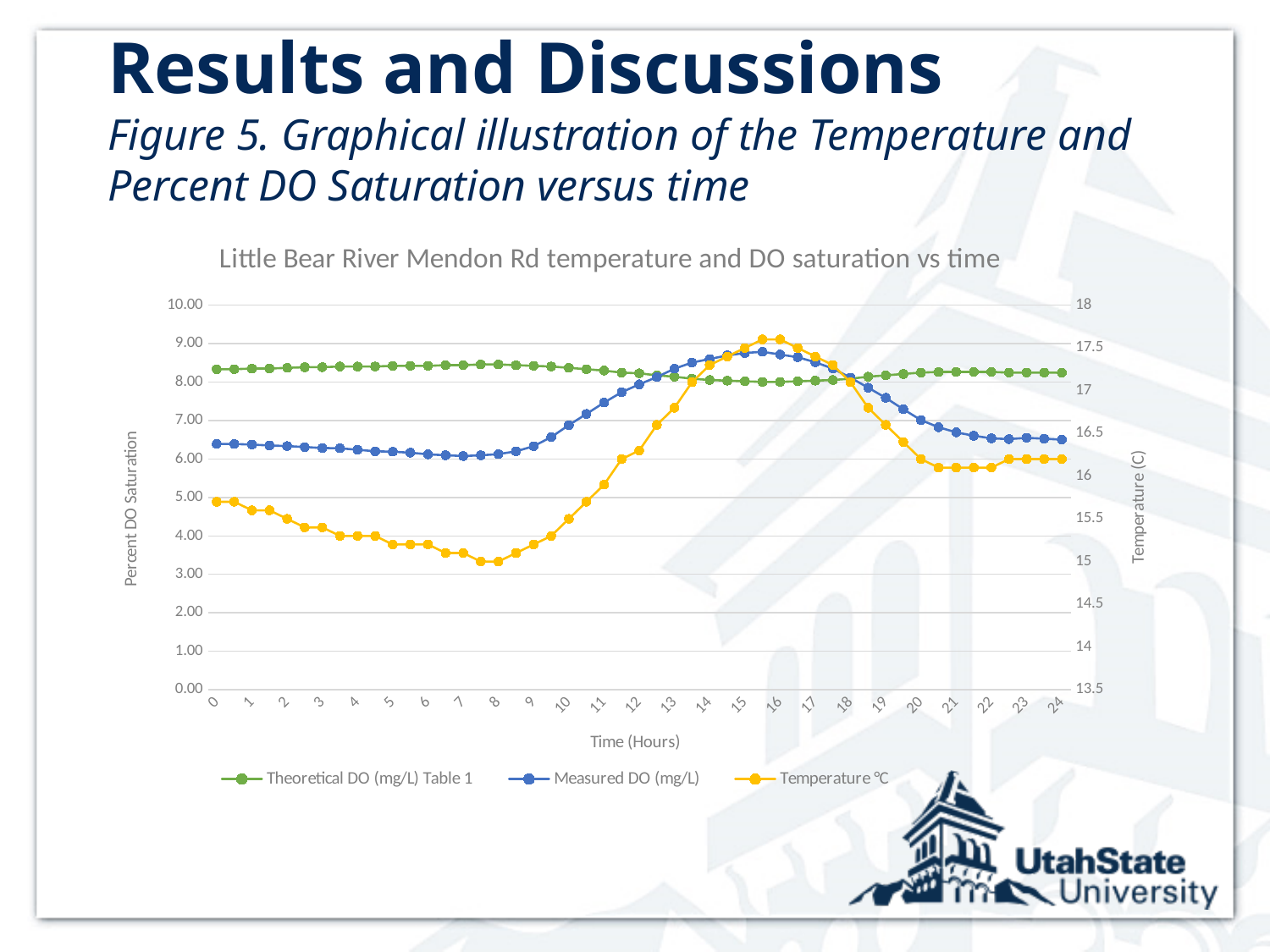
At hour 0, which is larger: Theoretical DO (mg/L) Table 1 or Measured DO (mg/L)? Theoretical DO (mg/L) Table 1 Is the Temperature °C value at hour 16 greater or less than 17 on the right axis? greater Does the Measured DO (mg/L) series rise or fall between hour 8 and hour 15? rise Does the Temperature °C series rise or fall between hour 16 and hour 21? fall How many series does the chart legend list? 3 Is the Measured DO (mg/L) value at hour 0 greater or less than 7.00? less What kind of chart is shown on the slide? line chart Is the Temperature °C value at hour 0 greater or less than 16 on the right axis? less What is the title of the chart? Little Bear River Mendon Rd temperature and DO saturation vs time Which series is plotted in yellow according to the legend? Temperature °C